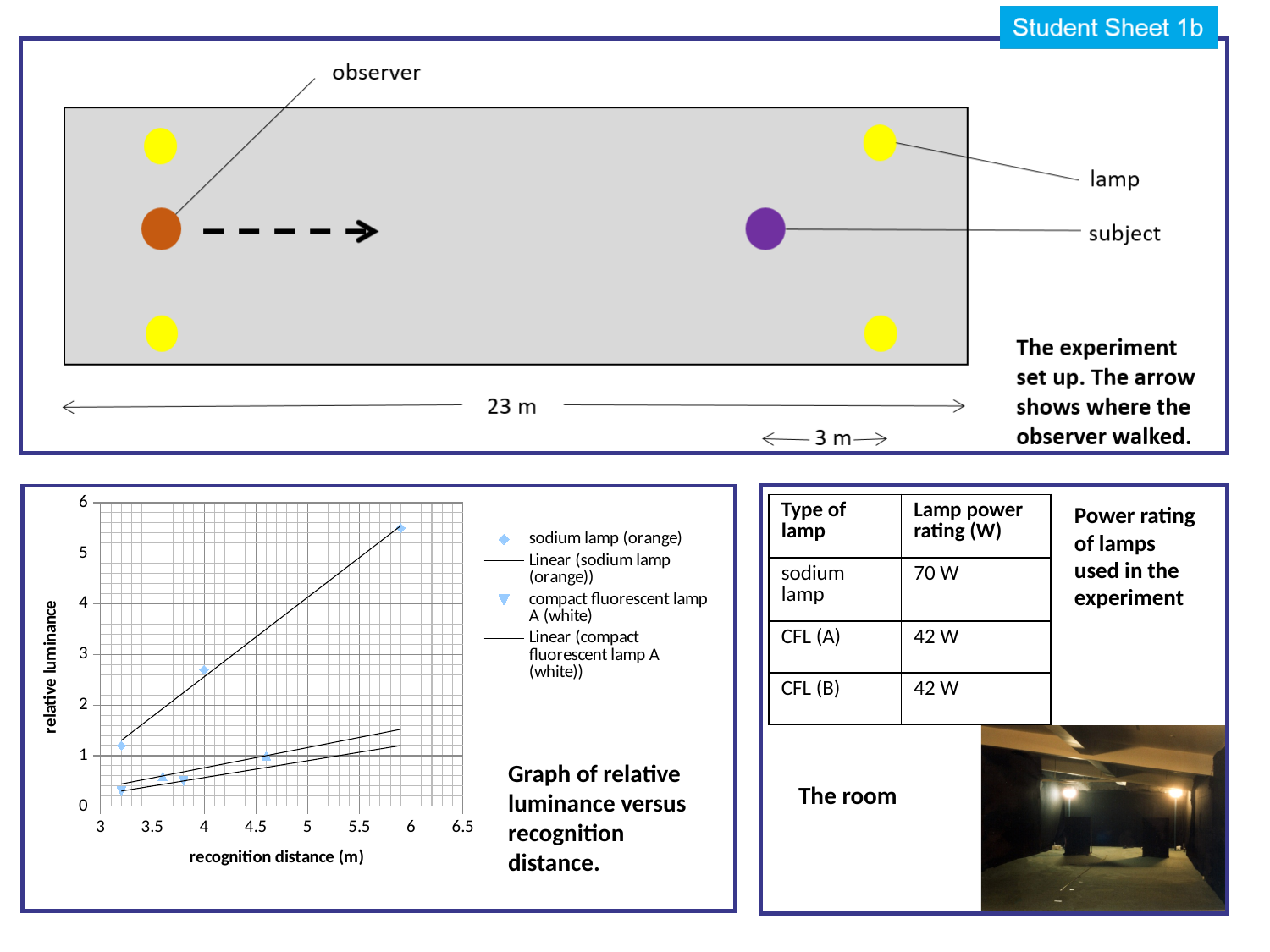
In the luminance chart, is the relative luminance of the sodium lamp (orange) point at about 5.9 m greater or less than 5? greater In the luminance chart, which series reaches the highest relative luminance? sodium lamp (orange) What is the label on the x axis of the luminance chart? recognition distance (m) In the luminance chart, does relative luminance for the sodium lamp (orange) rise or fall as recognition distance increases? rise How many data points are plotted for the sodium lamp (orange) series in the luminance chart? 3 In the luminance chart, is the relative luminance of the sodium lamp (orange) point at about 4 m greater or less than 2? greater How many entries does the legend of the luminance chart list? 4 In the luminance chart, which series has the higher relative luminance at a recognition distance of about 3.2 m, sodium lamp (orange) or compact fluorescent lamp A (white)? sodium lamp (orange) What is the label on the y axis of the luminance chart? relative luminance In the luminance chart, which series has the lowest relative luminance values? compact fluorescent lamp A (white) What kind of chart is the graph of relative luminance versus recognition distance? scatter chart